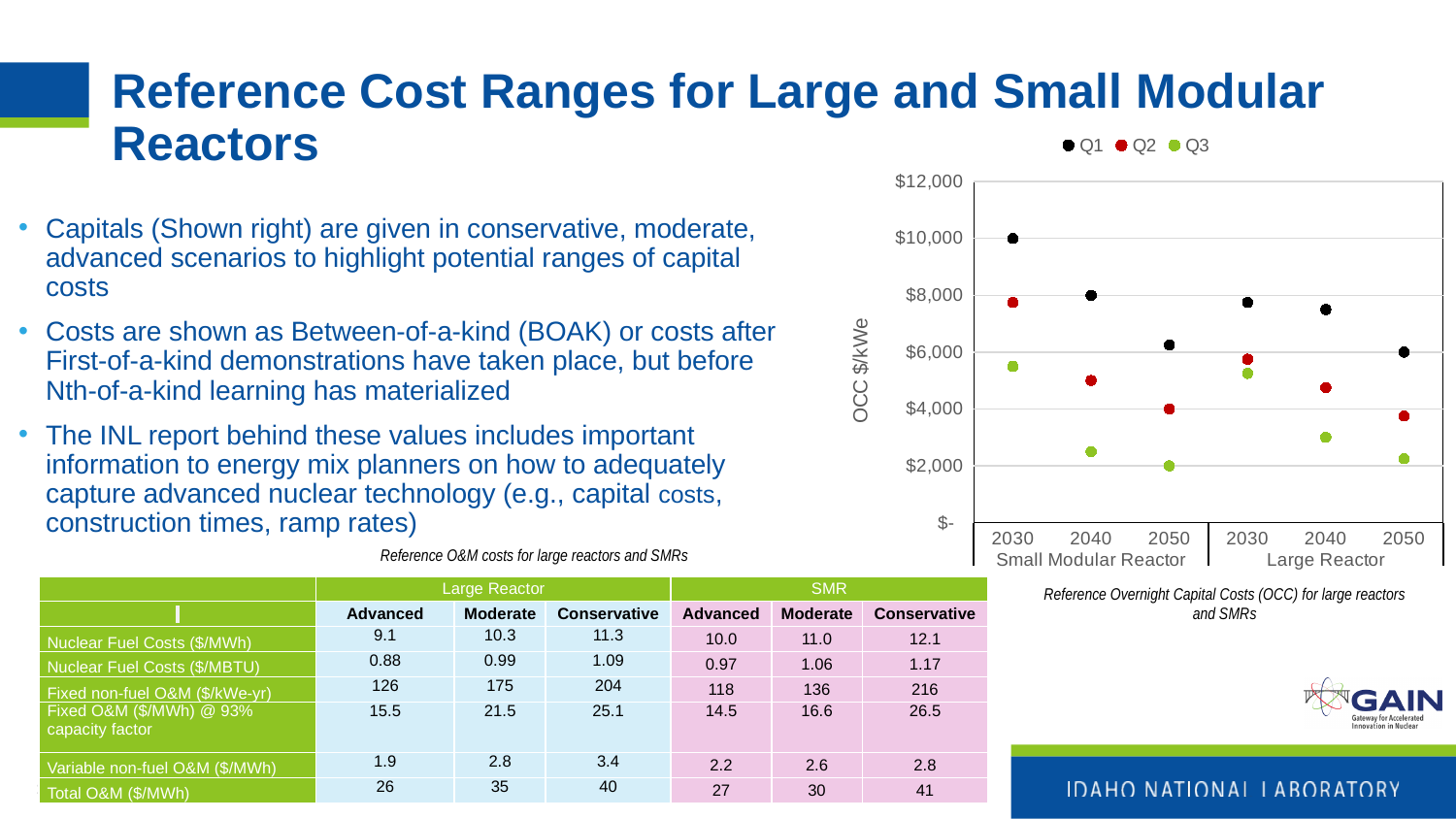
Which is larger: the Q1 value for Small Modular Reactor in 2030 or the Q1 value for Large Reactor in 2030? Small Modular Reactor in 2030 Is the Q3 value for Small Modular Reactor in 2040 greater or less than $4,000? less Which year has the highest Q1 value for the Small Modular Reactor? 2030 How many year categories are plotted on the x axis of the chart in total? 6 How many series does the chart legend list? 3 Is the Q1 value for Small Modular Reactor in 2030 greater or less than $8,000? greater Which year has the lowest Q3 value for the Small Modular Reactor? 2050 What are the series names shown in the chart legend? Q1, Q2, Q3 Is the Q1 value for Large Reactor in 2040 greater or less than $6,000? greater Do the Q1 values for the Small Modular Reactor rise or fall from 2030 to 2050? fall What is the label on the vertical axis of the chart? OCC $/kWe